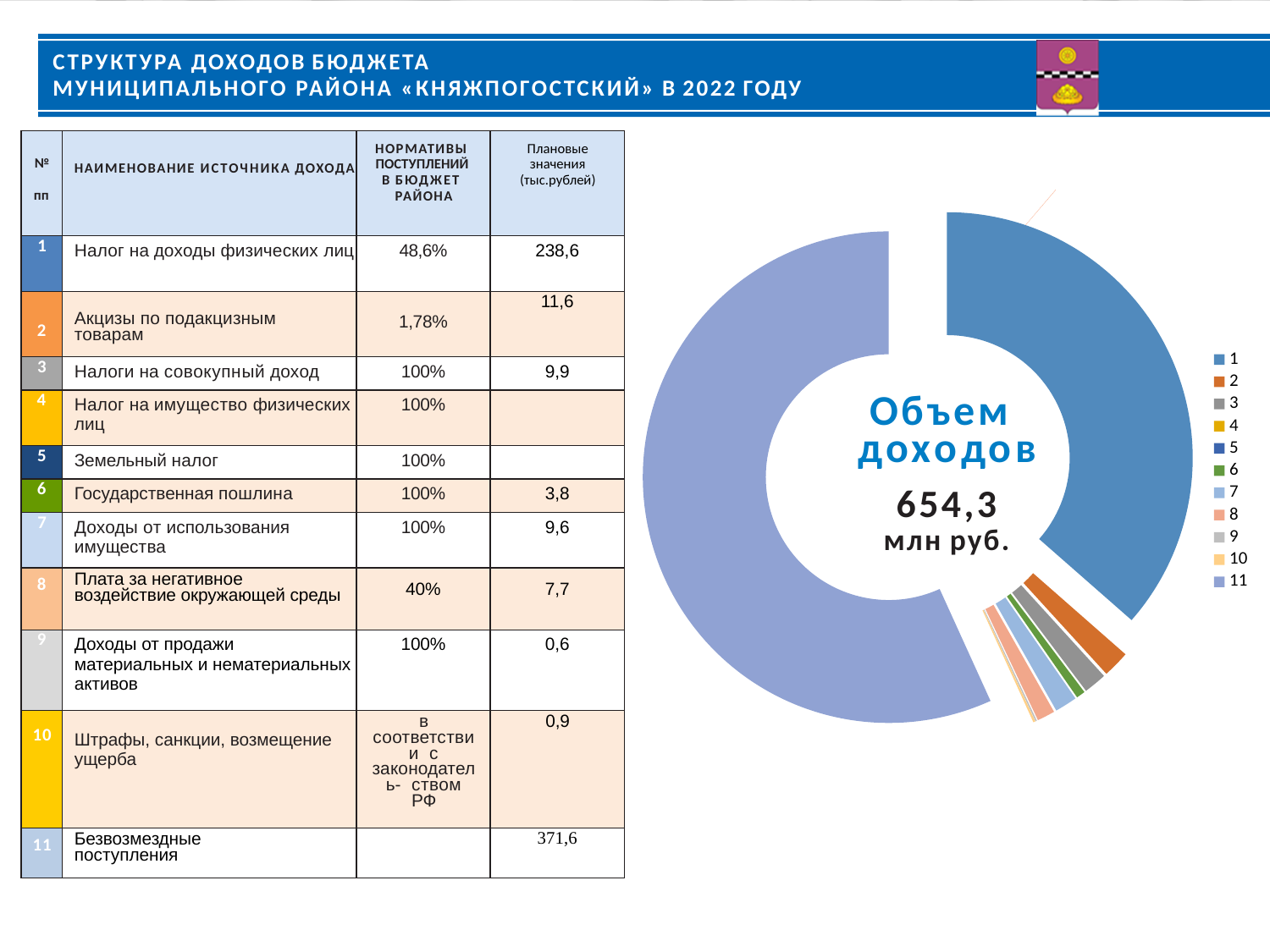
Which slice is larger in the pie chart, category 11 or category 1? 11 Which slice is larger in the pie chart, category 1 or category 3? 1 How many categories does the legend of the pie chart list? 11 Which legend category has the largest slice in the pie chart? 11 What colour is legend entry 2 in the pie chart? orange What kind of chart is shown on the right side of the slide? doughnut chart What total income value is printed in the centre of the pie chart? 654,3 млн руб. Which slice is larger in the pie chart, category 1 or category 2? 1